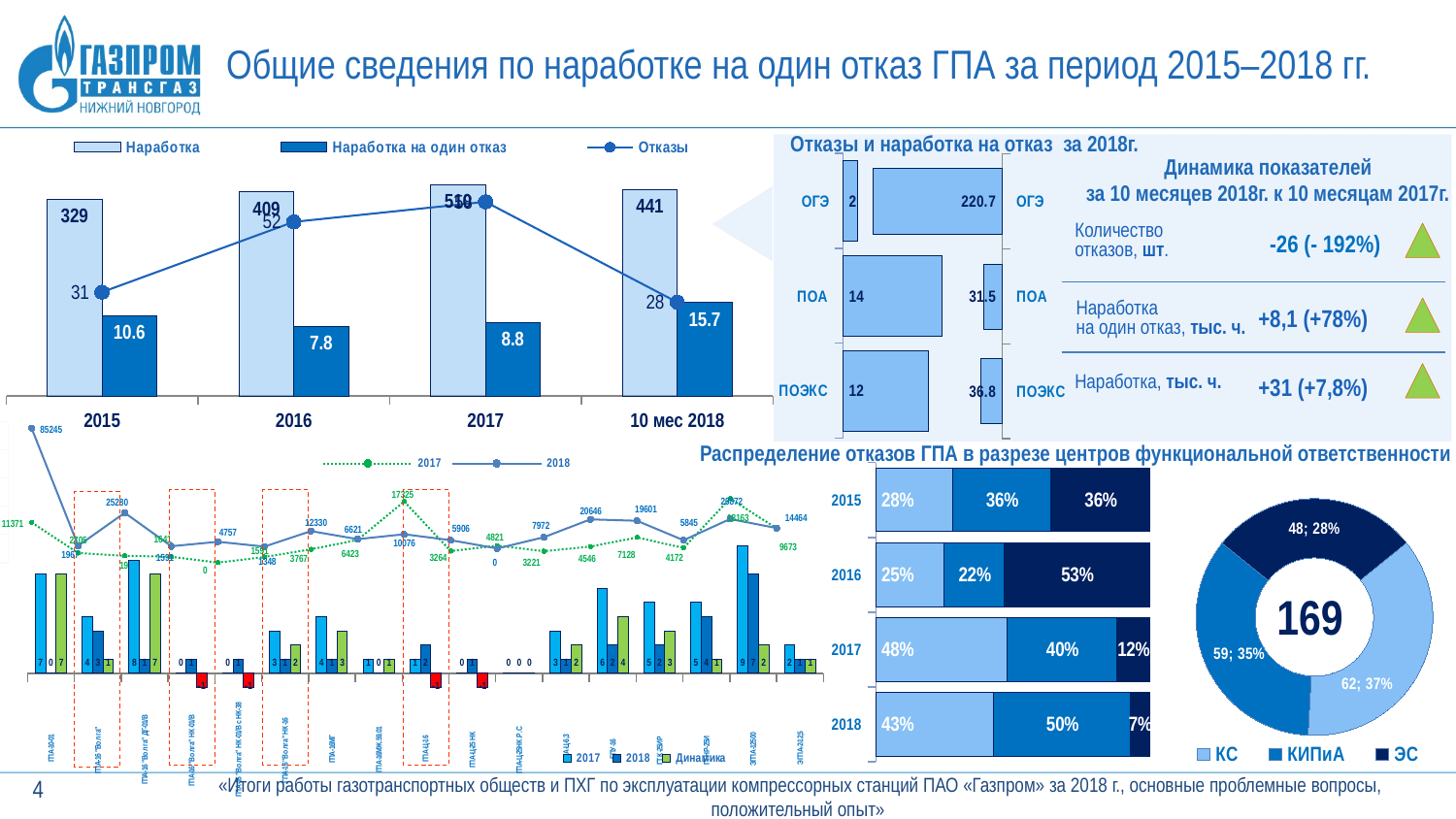
In the top-left chart, what is the difference between Наработка for 2016 and 2015? 80 In the top-left chart, what is the value of Наработка на один отказ for 10 мес 2018? 15.7 In the chart 'Отказы и наработка на отказ за 2018г.', what is the наработка на отказ value for ОГЭ? 220.7 In the donut chart at the bottom right, what is the total shown in the centre? 169 In the donut chart at the bottom right, what is the share of the segment with value 62? 37% In the top-left chart, which category has the lowest value of Наработка на один отказ? 2016 In the top-left chart, what is the value of Отказы for 2016? 52 In the chart 'Отказы и наработка на отказ за 2018г.', which category has the highest number of отказы? ПОА In the chart 'Распределение отказов ГПА в разрезе центров функциональной ответственности', what is the share of ЭС in 2016? 53% In the top-left chart, what is the value of Наработка for 2015? 329 In the top-left chart, how many series does the legend list? 3 In the chart 'Распределение отказов ГПА в разрезе центров функциональной ответственности', which is larger in 2018: КС or КИПиА? КИПиА